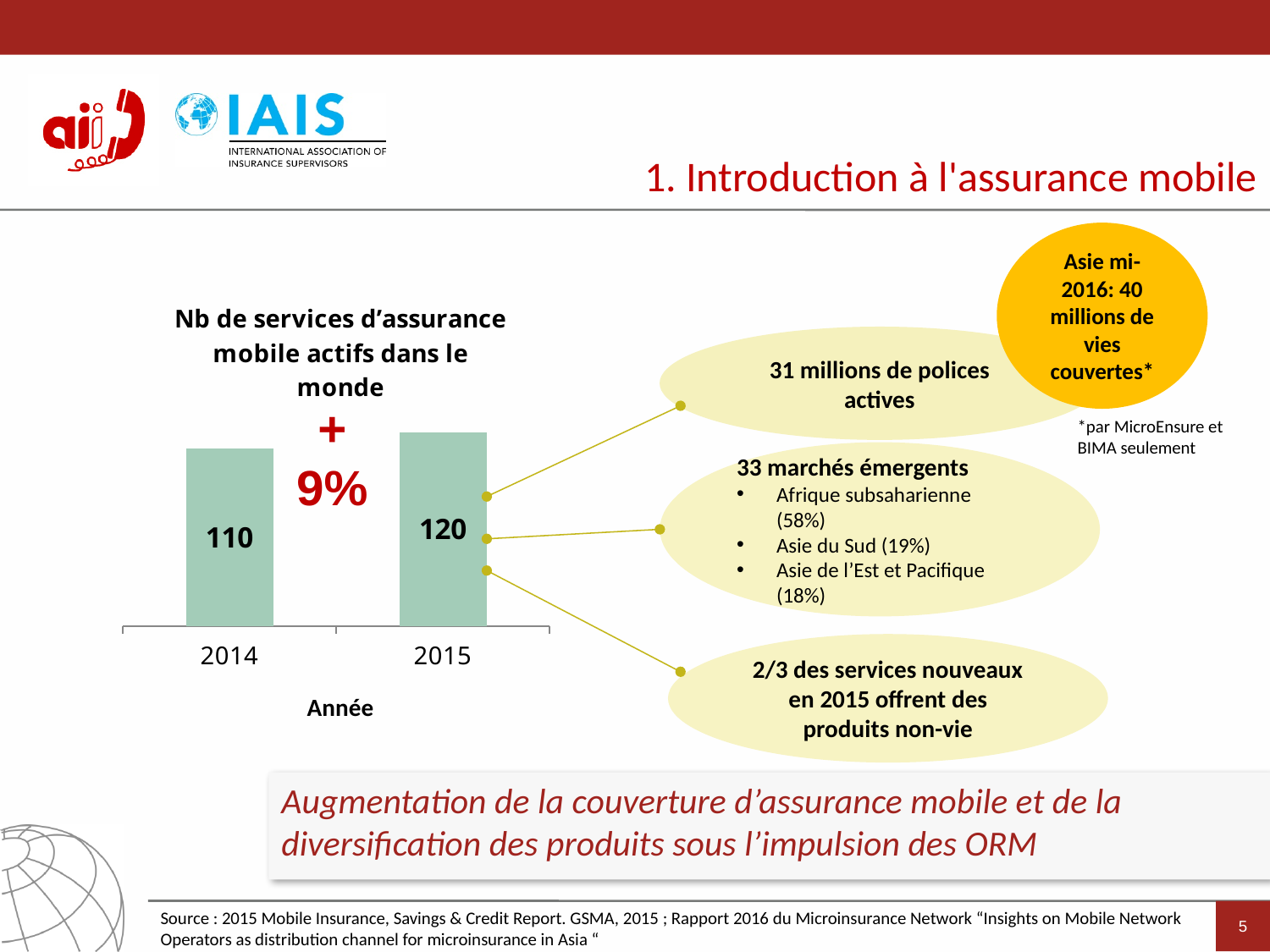
What is the title of the chart? Nb de services d’assurance mobile actifs dans le monde How many years are shown on the x axis of the chart? 2 What is the label of the x axis of the chart? Année What is the difference between the 2015 and 2014 values? 10 What kind of chart is shown on the slide? Bar chart Is the value for 2015 larger than the value for 2014? Yes Which year has the lower number of active mobile insurance services? 2014 Do the values rise or fall from 2014 to 2015? Rise Which year has the higher number of active mobile insurance services? 2015 What is the value for 2015 in the chart? 120 What percentage increase is annotated between the two bars? + 9% What is the value for 2014 in the chart? 110